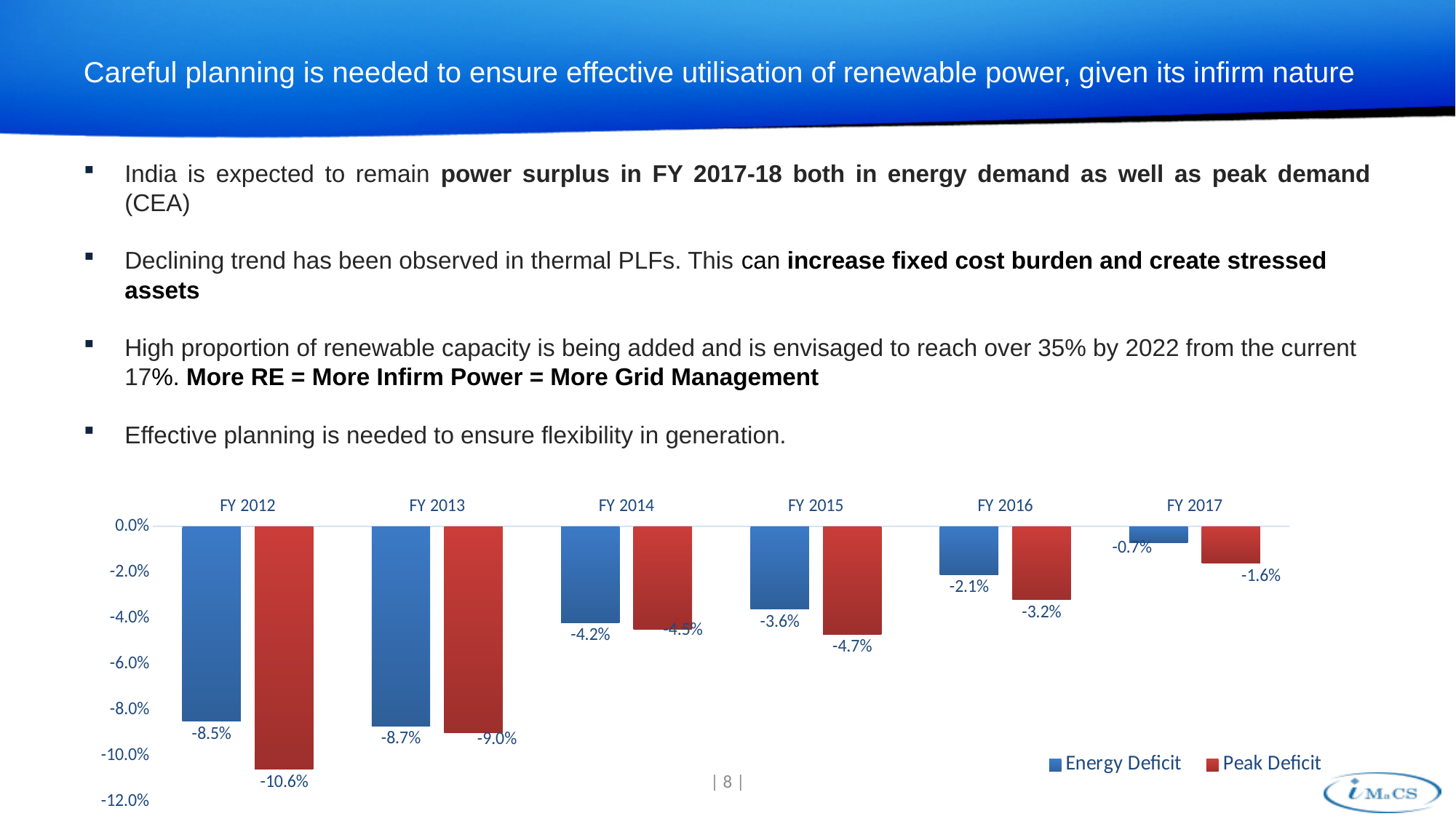
Which is more negative in FY 2016, the Energy Deficit or the Peak Deficit? Peak Deficit Do the Energy Deficit values move closer to zero or further from zero from FY 2012 to FY 2017? Closer to zero What is the Energy Deficit value for FY 2012? -8.5% How many series does the legend list? 2 In which fiscal year is the Energy Deficit bar the shortest (closest to zero)? FY 2017 What kind of chart is shown on the slide? Bar chart What is the Energy Deficit value for FY 2017? -0.7% What is the Peak Deficit value for FY 2013? -9.0% What is the difference between the Peak Deficit and Energy Deficit values in FY 2012? 2.1 percentage points How many fiscal years are shown on the x axis? 6 What is the Peak Deficit value for FY 2015? -4.7% In which fiscal year is the Peak Deficit bar the longest (most negative)? FY 2012